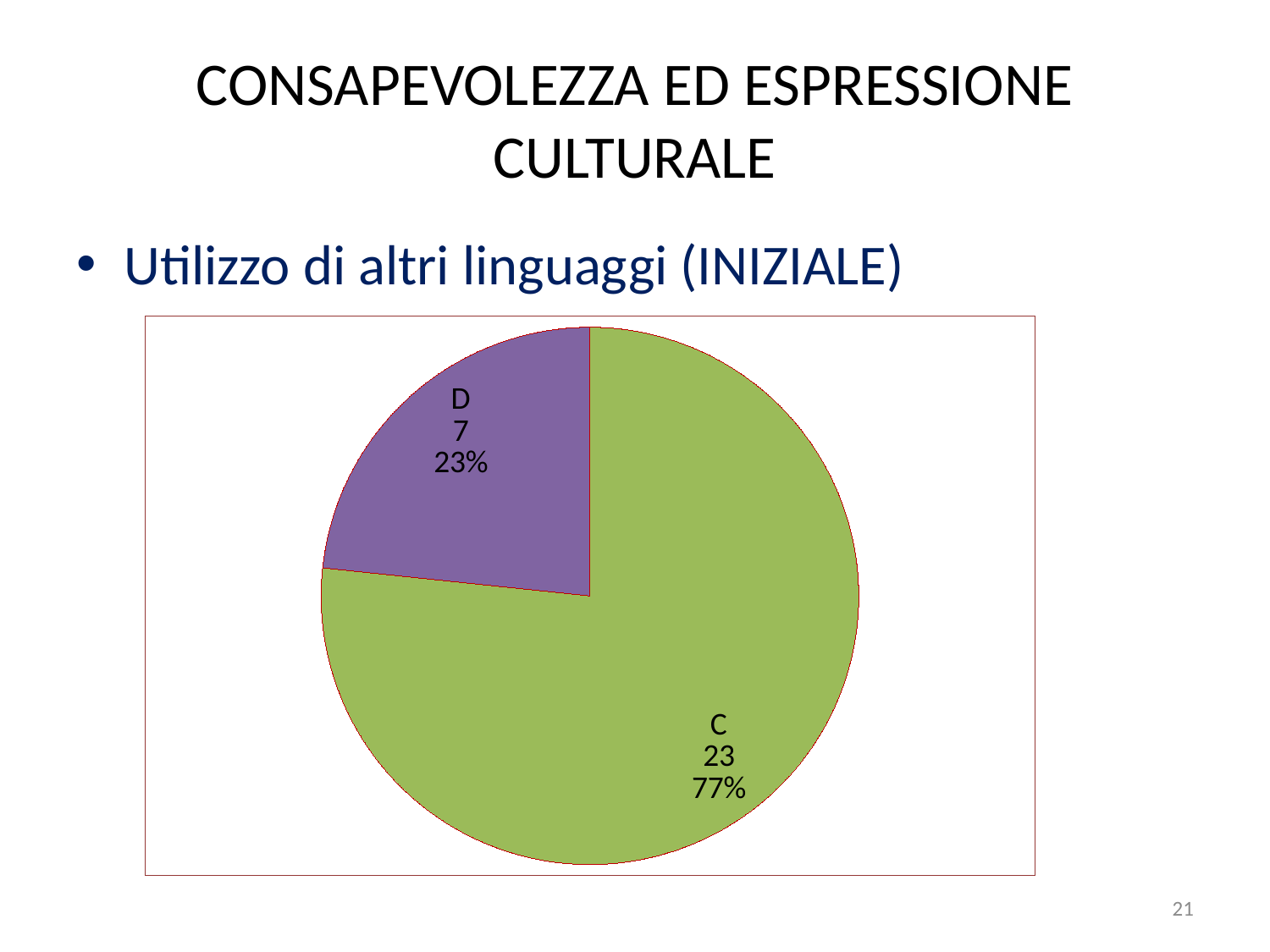
What is the difference between the values of C and D? 16 What share of the pie does slice D represent? 23% What is the value for slice D? 7 Which is larger, the value for C or the value for D? C What share of the pie does slice C represent? 77% How many slices does the pie chart have? 2 What kind of chart is shown on the slide? pie chart What is the total of the values of all slices? 30 Which slice is the largest? C Which slice is the smallest? D What is the value for slice C? 23 What colour is the slice for D? purple